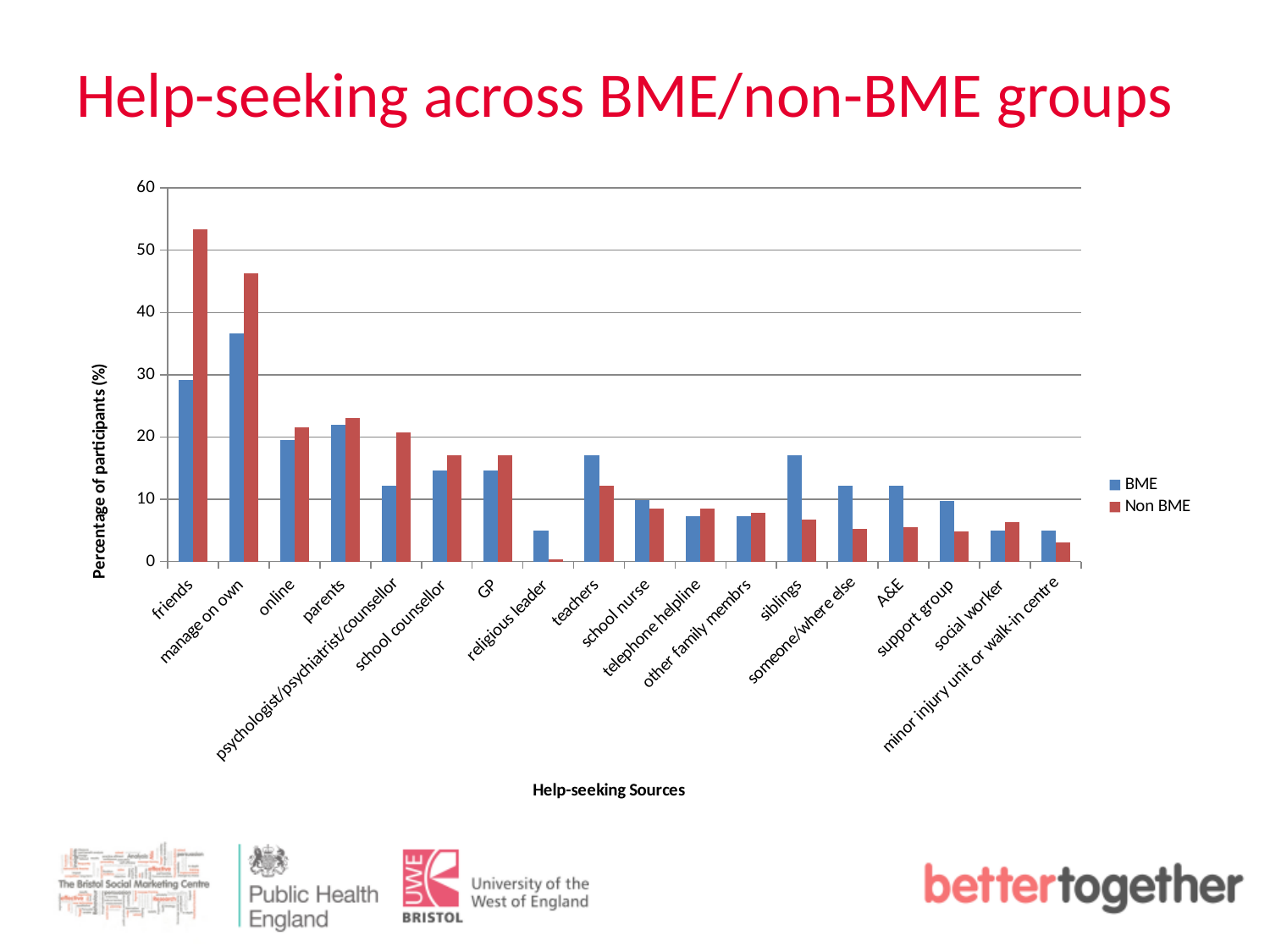
For siblings, which series has the larger value, BME or Non BME? BME How many series does the legend list? 2 Is the BME value for siblings greater or less than 10? greater Is the Non BME value for friends greater or less than 50? greater Which help-seeking source has the lowest value for the Non BME series? religious leader What is the label of the y axis? Percentage of participants (%) How many help-seeking source categories are shown on the x axis? 18 Which help-seeking source has the highest value for the Non BME series? friends What kind of chart is shown on the slide? bar chart Which help-seeking source has the highest value for the BME series? manage on own Is the BME value for manage on own greater or less than 30? greater For friends, which series has the larger value, BME or Non BME? Non BME